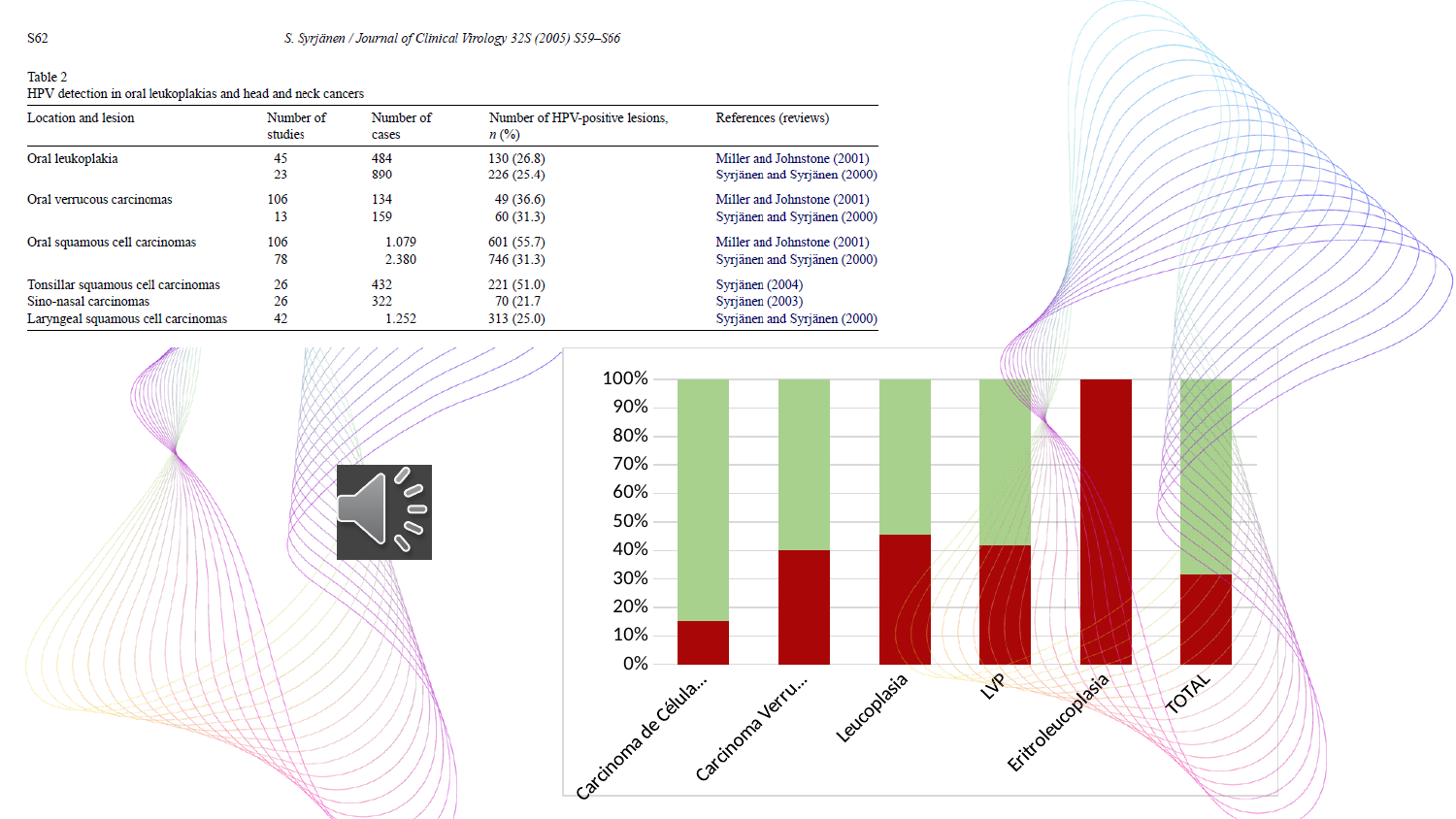
Which has the larger red segment, Carcinoma de Célula... or Carcinoma Verru...? Carcinoma Verru... Is the red segment for LVP greater or less than 30%? greater What is the highest value shown on the y axis of the chart? 100% Which category has the largest red segment in the chart? Eritroleucoplasia Which has the larger red segment, Leucoplasia or TOTAL? Leucoplasia Is the red segment for Leucoplasia greater or less than 50%? less Is the red segment for TOTAL greater or less than 40%? less What kind of chart is shown on the slide? Stacked bar chart Which category has the smallest red segment in the chart? Carcinoma de Célula... How many categories are shown on the x axis of the chart? 6